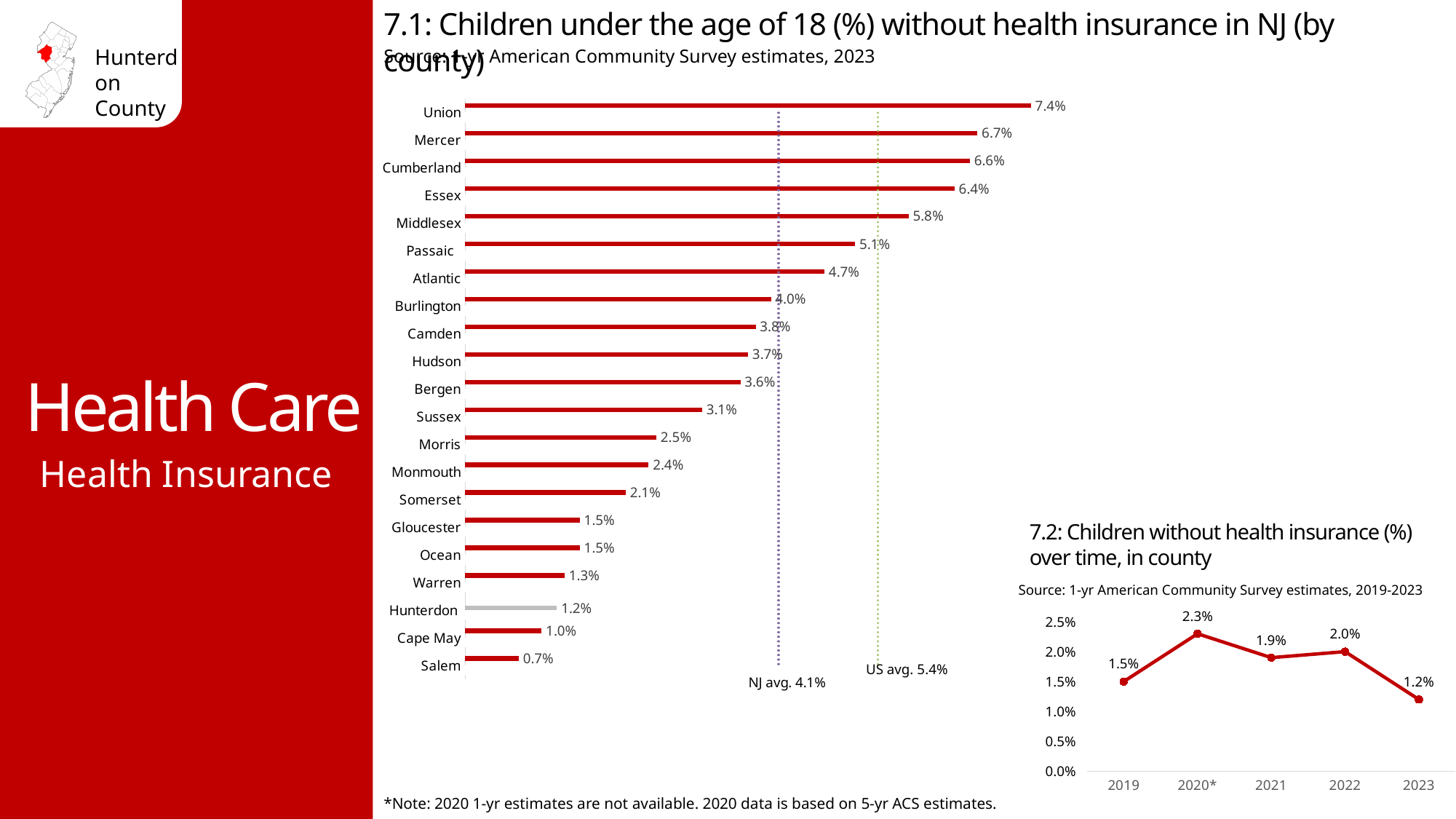
In chart 7.2, how many data points are plotted? 5 In chart 7.1, how many counties are shown? 21 In chart 7.1, what is the value for Passaic? 5.1% In chart 7.2, what is the difference between the values for 2022 and 2023? 0.8% What kind of chart is chart 7.2? line chart In chart 7.1, what is the difference between the values for Union and Salem? 6.7% In chart 7.1, which has a higher value, Essex or Middlesex? Essex In chart 7.1, which county has the highest percentage of children without health insurance? Union In chart 7.1, what is the NJ average shown by the dotted reference line? 4.1% In chart 7.1, which county has the lowest percentage of children without health insurance? Salem In chart 7.1, what is the value for Hunterdon? 1.2% In chart 7.2, what is the value for 2020*? 2.3%